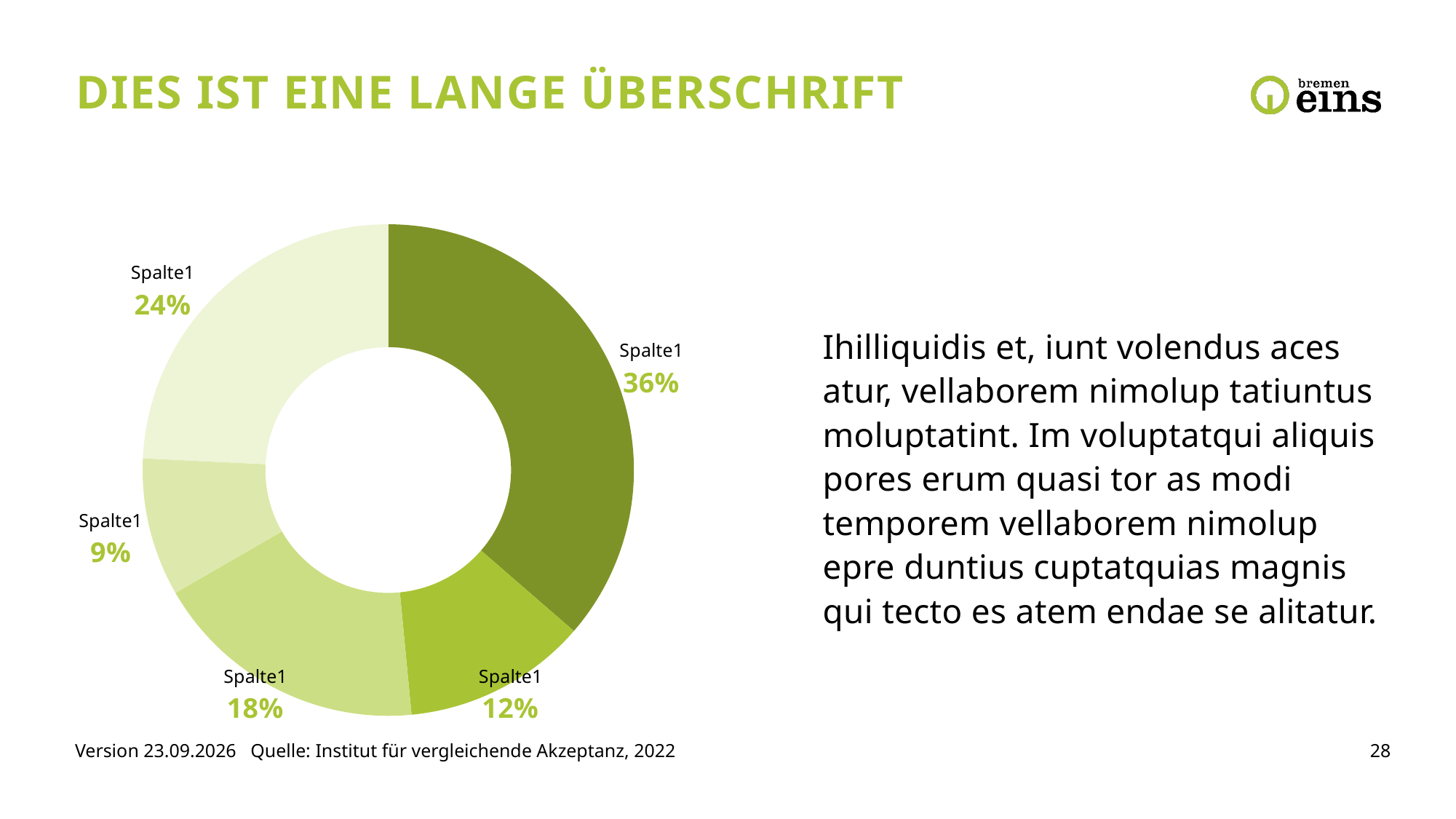
What share does the slice at the bottom left of the pie chart have? 18% How many slices does the pie chart have? 5 What is the largest share shown in the pie chart? 36% What share does the darkest green slice on the right side of the pie chart have? 36% What kind of chart is shown on the slide? Pie chart (donut) What share does the slice at the bottom right of the pie chart, next to the darkest slice, have? 12% What is the smallest share shown in the pie chart? 9% Which is larger: the slice labelled 24% or the slice labelled 18%? The 24% slice What is the difference between the largest slice (36%) and the smallest slice (9%)? 27 percentage points What is the difference between the 24% slice and the 12% slice? 12 percentage points What label is used for every slice of the pie chart? Spalte1